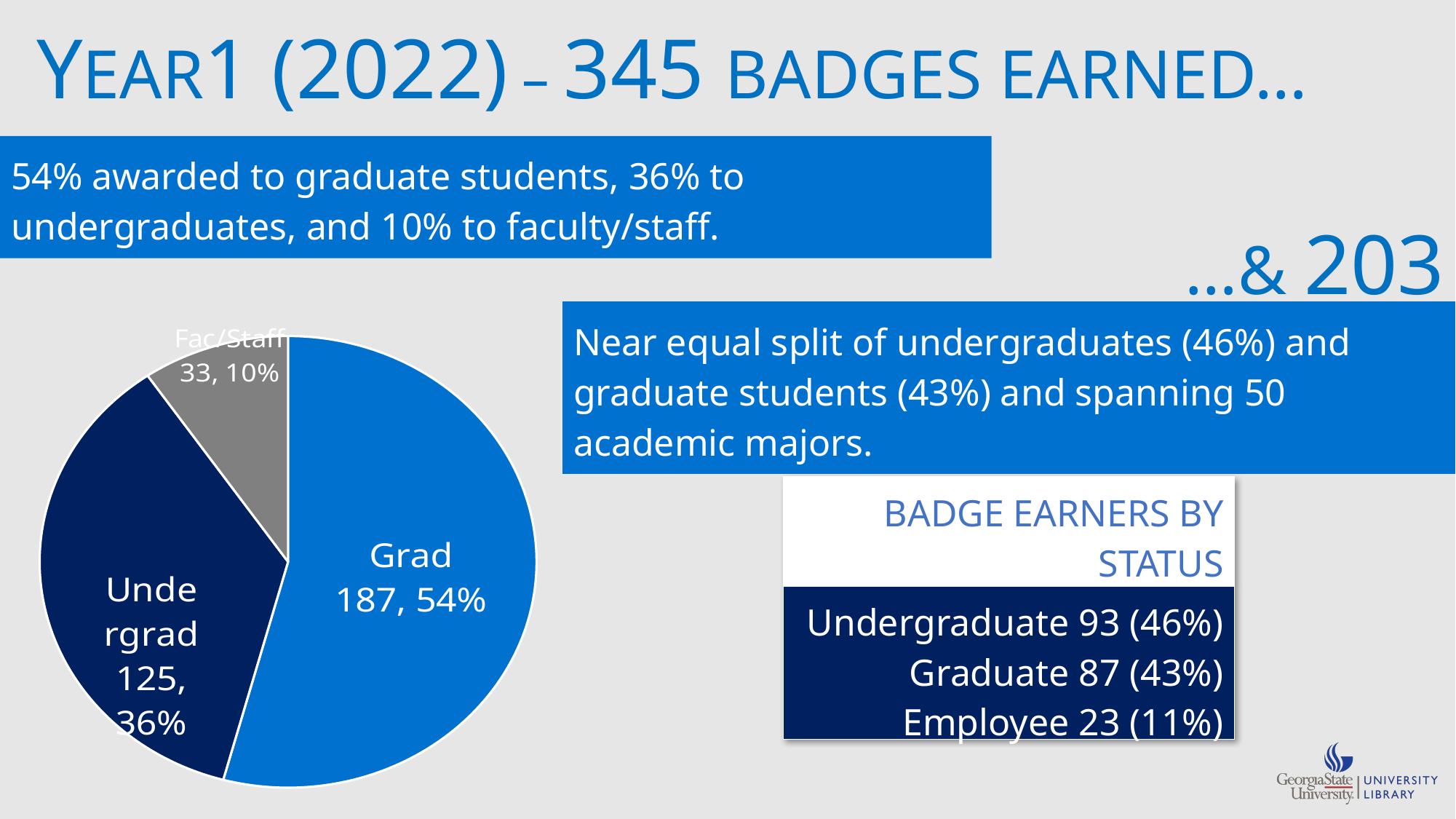
What is the value for Undergrad in the pie chart? 125 What share of the pie does the Fac/Staff slice represent? 10% What share of the pie does the Grad slice represent? 54% What colour is the Grad slice in the pie chart? blue What is the value for Fac/Staff in the pie chart? 33 What is the value for Grad in the pie chart? 187 Which is larger in the pie chart, Undergrad or Fac/Staff? Undergrad Which category has the smallest slice in the pie chart? Fac/Staff What is the difference between the Grad and Undergrad values in the pie chart? 62 Which category has the largest slice in the pie chart? Grad How many slices does the pie chart have? 3 What kind of chart is shown on the slide? pie chart